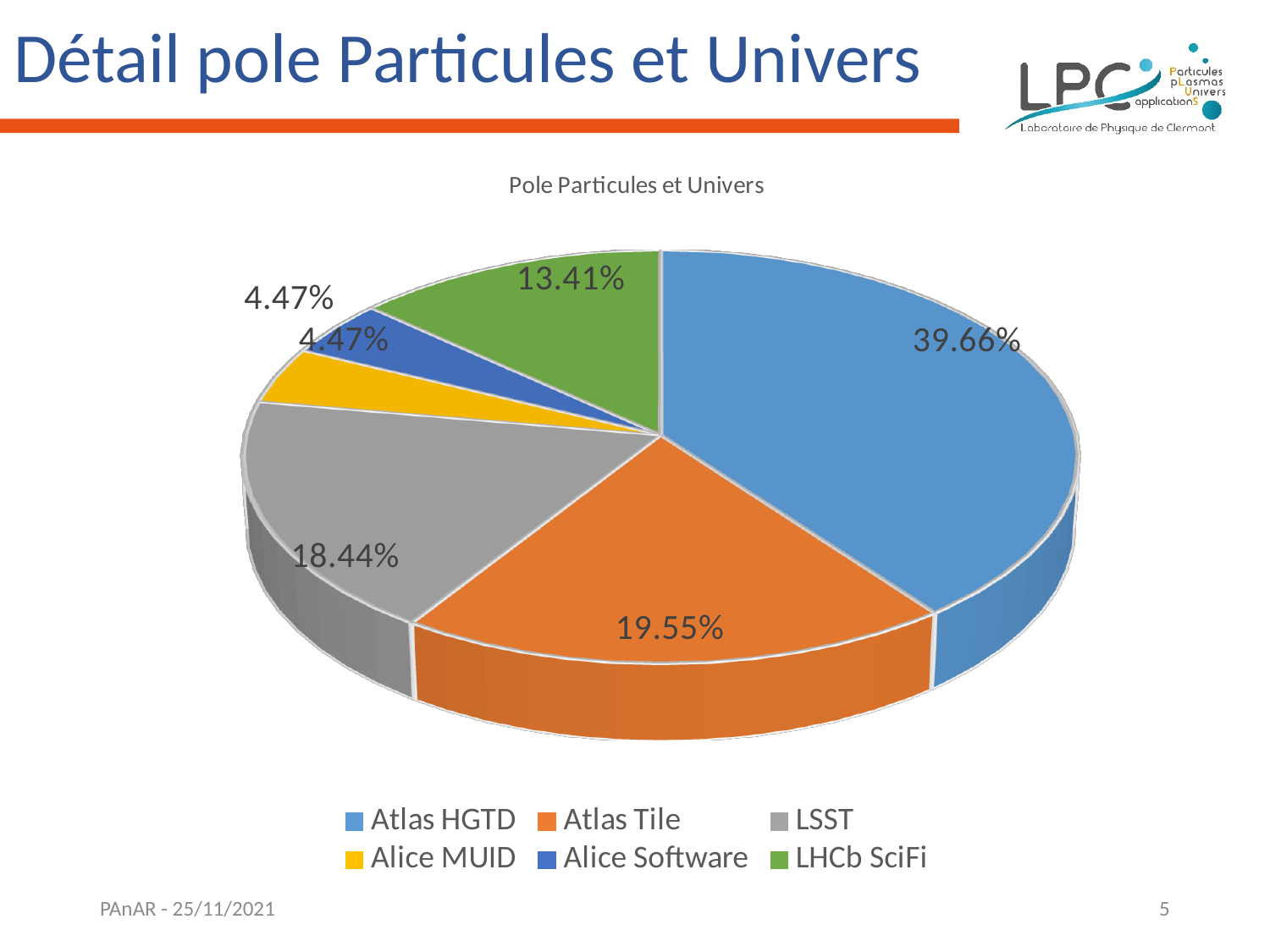
What percentage is shown for Atlas Tile? 19.55% What share of the pie does Atlas HGTD represent? 39.66% How many categories does the legend list? 6 What type of chart is shown on the slide? Pie chart What percentage is shown for LSST? 18.44% What is the chart title? Pole Particules et Univers What percentage is shown for Alice MUID? 4.47% Which category has the largest slice of the pie? Atlas HGTD Which is larger, the share for Atlas Tile or the share for LSST? Atlas Tile Which colour represents LHCb SciFi in the legend? Green What percentage is shown for LHCb SciFi? 13.41% What is the difference in percentage points between Atlas HGTD and Atlas Tile? 20.11